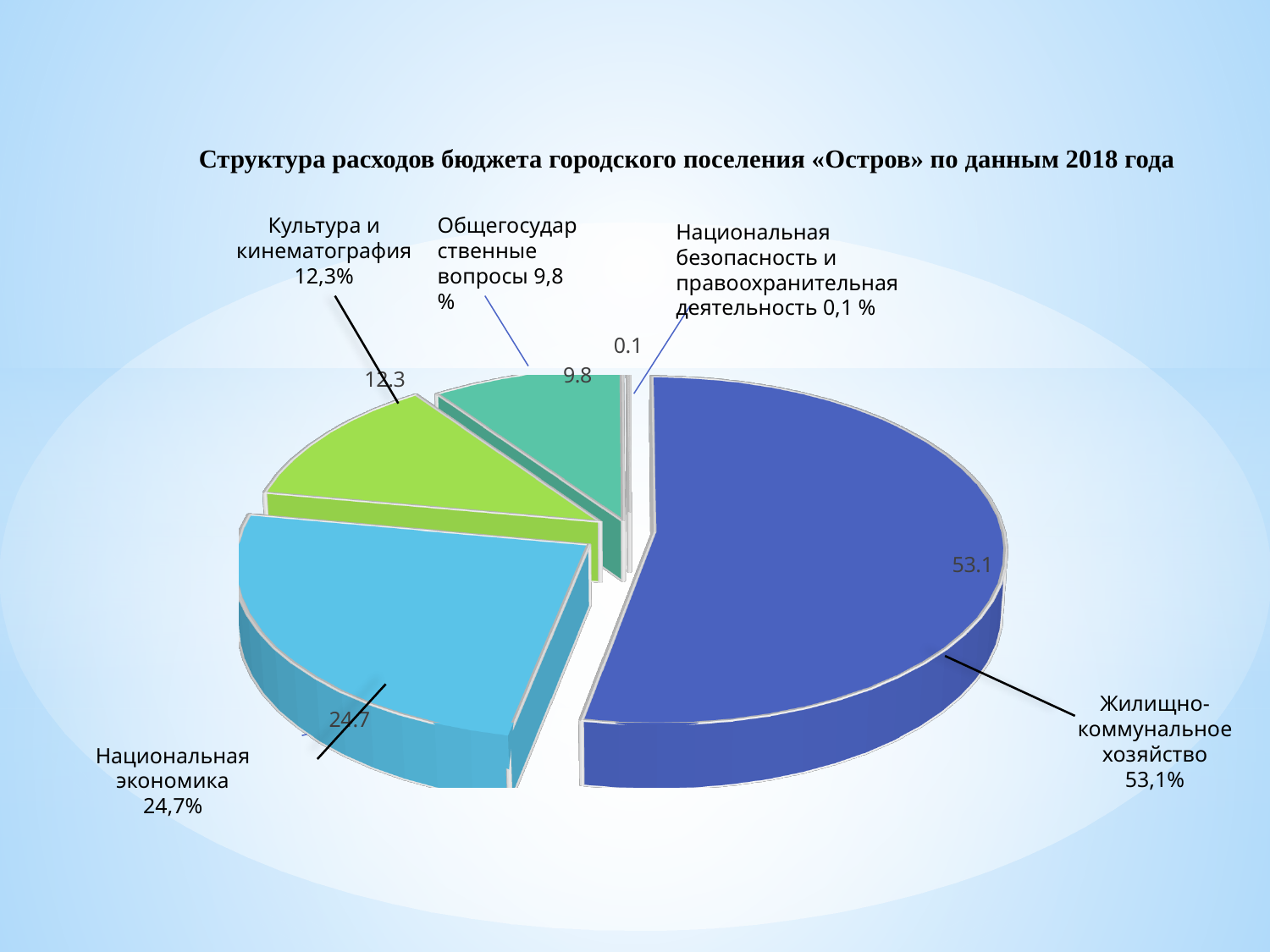
What is the value shown for Культура и кинематография? 12.3 What is the value shown for Жилищно-коммунальное хозяйство? 53.1 What is the value shown for Общегосударственные вопросы? 9.8 Which category has the smallest slice of the pie? Национальная безопасность и правоохранительная деятельность What kind of chart is shown on the slide? pie chart What is the value shown for Национальная экономика? 24.7 Which category has the largest slice of the pie? Жилищно-коммунальное хозяйство Which is larger, the slice for Культура и кинематография or the slice for Общегосударственные вопросы? Культура и кинематография What is the value shown for Национальная безопасность и правоохранительная деятельность? 0.1 How many slices does the pie chart have? 5 What is the title of the chart? Структура расходов бюджета городского поселения «Остров» по данным 2018 года What is the difference between the values for Жилищно-коммунальное хозяйство and Национальная экономика? 28.4